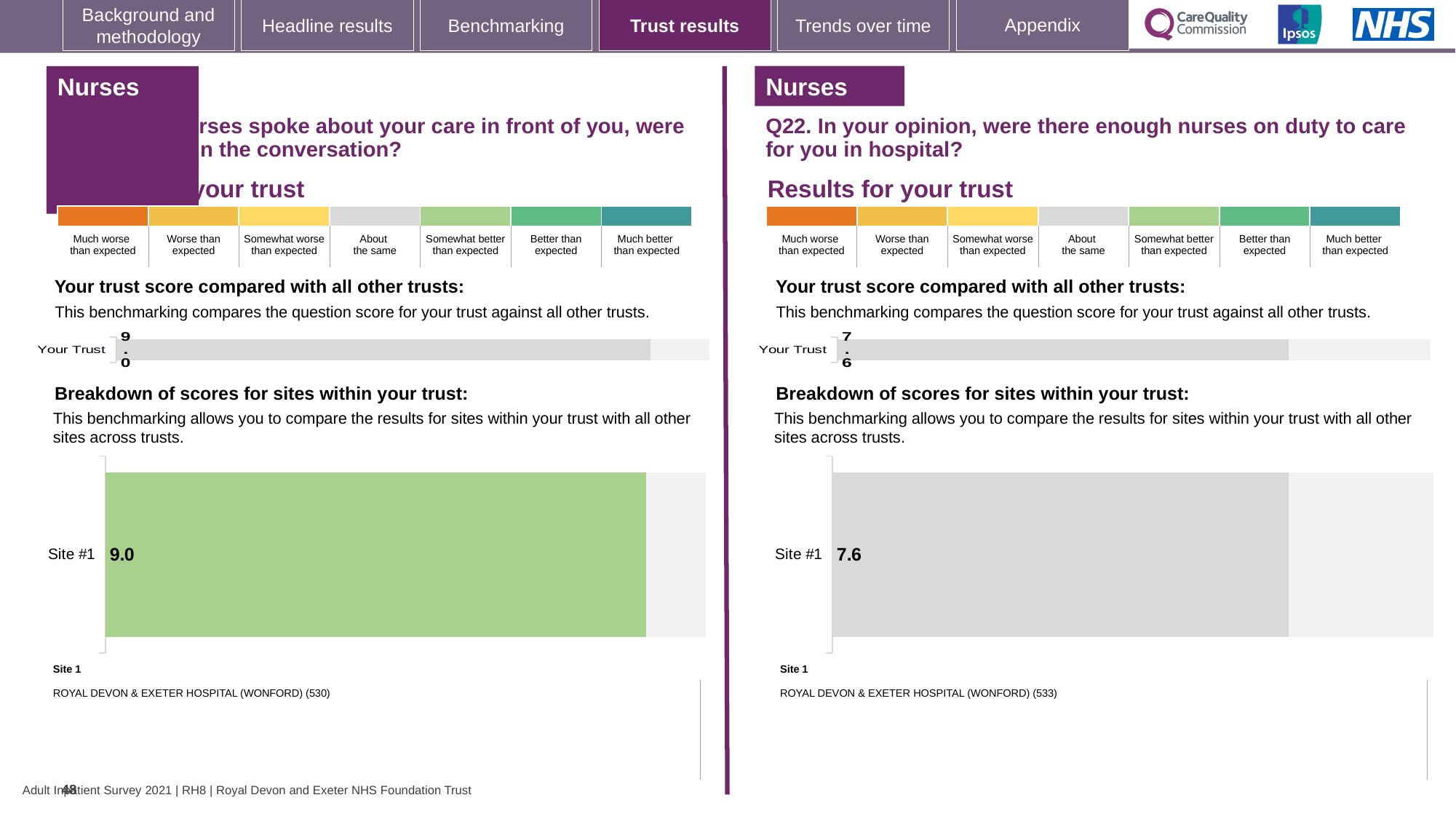
On the left-hand panel, what is the score shown for Your Trust? 9.0 What colour is the Site #1 bar on the right-hand panel (Q22)? Grey On the right-hand panel (Q22), what is the score shown for Site #1? 7.6 What is the difference between the Your Trust score on the left-hand panel and the Your Trust score on the right-hand panel (Q22)? 1.4 What colour is the Site #1 bar on the left-hand panel? Green What is the difference between the Site #1 score on the left-hand panel and the Site #1 score on the right-hand panel (Q22)? 1.4 On the left-hand panel, what is the score shown for Site #1? 9.0 On the right-hand panel (Q22), what is the score shown for Your Trust? 7.6 Which site is listed as Site 1 on the right-hand panel (Q22)? ROYAL DEVON & EXETER HOSPITAL (WONFORD) (533) How many sites are shown in the breakdown of scores chart on the right-hand panel (Q22)? 1 Which is larger: the Site #1 score on the left-hand panel or the Site #1 score on the right-hand panel (Q22)? Left-hand panel (9.0) What type of chart is used to show the Site #1 score on the right-hand panel (Q22)? Bar chart